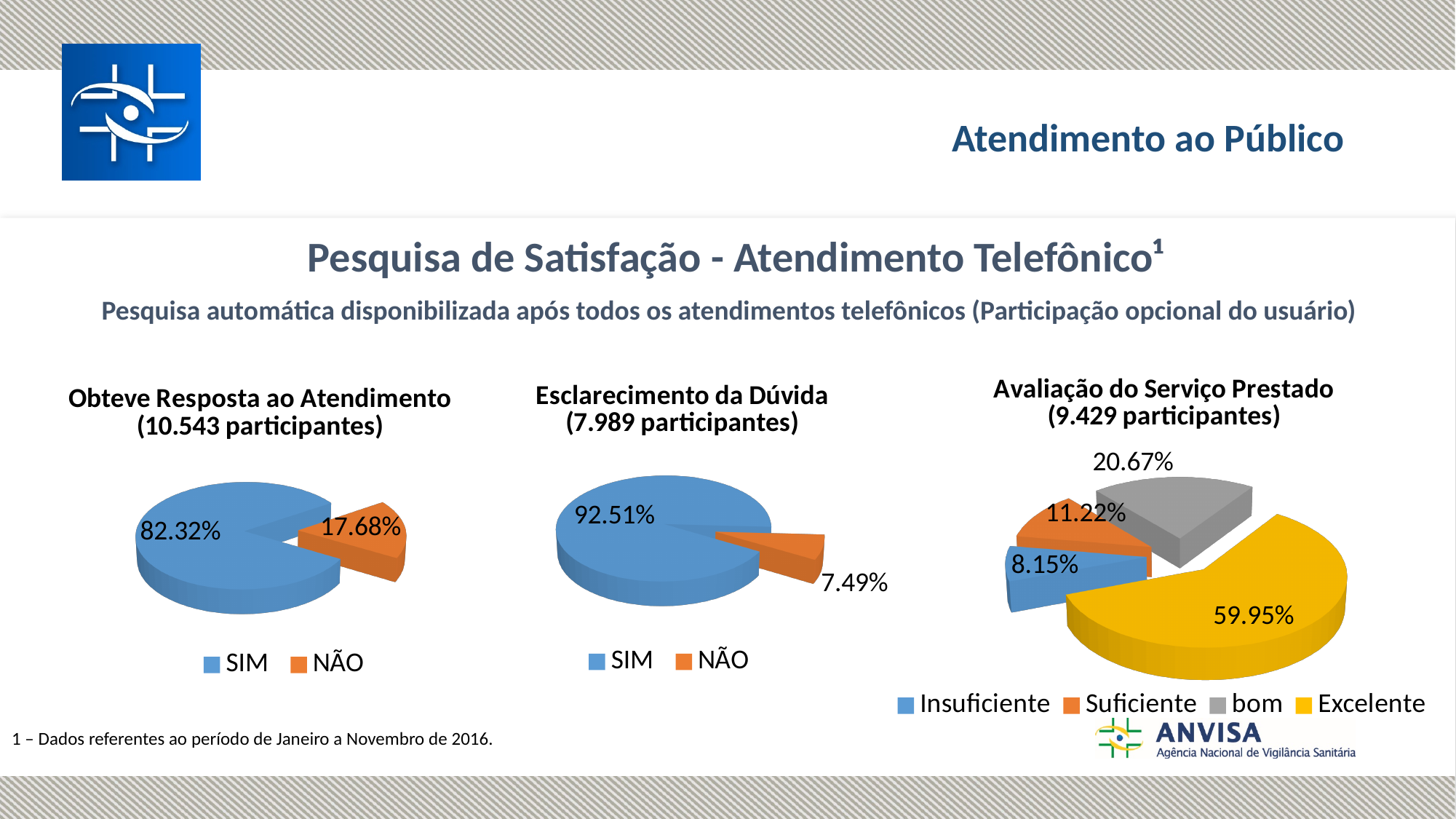
What type of chart is used for 'Obteve Resposta ao Atendimento'? Pie chart How many categories does the legend of the 'Avaliação do Serviço Prestado' chart list? 4 In the 'Avaliação do Serviço Prestado' chart, which category has the largest slice? Excelente In the 'Esclarecimento da Dúvida' chart, what is the value for SIM? 92.51% In the 'Obteve Resposta ao Atendimento' chart, what percentage of participants answered NÃO? 17.68% In the 'Avaliação do Serviço Prestado' chart, what share of participants rated the service Excelente? 59.95% In the 'Obteve Resposta ao Atendimento' chart, what percentage of participants answered SIM? 82.32% In the 'Avaliação do Serviço Prestado' chart, what is the difference between the 'bom' and 'Suficiente' percentages? 9.45% In the 'Esclarecimento da Dúvida' chart, what is the difference between the SIM and NÃO percentages? 85.02% In the 'Avaliação do Serviço Prestado' chart, which category has the smallest slice? Insuficiente In the 'Esclarecimento da Dúvida' chart, what is the value for NÃO? 7.49% Which is larger: the NÃO share in the 'Obteve Resposta ao Atendimento' chart or the NÃO share in the 'Esclarecimento da Dúvida' chart? Obteve Resposta ao Atendimento